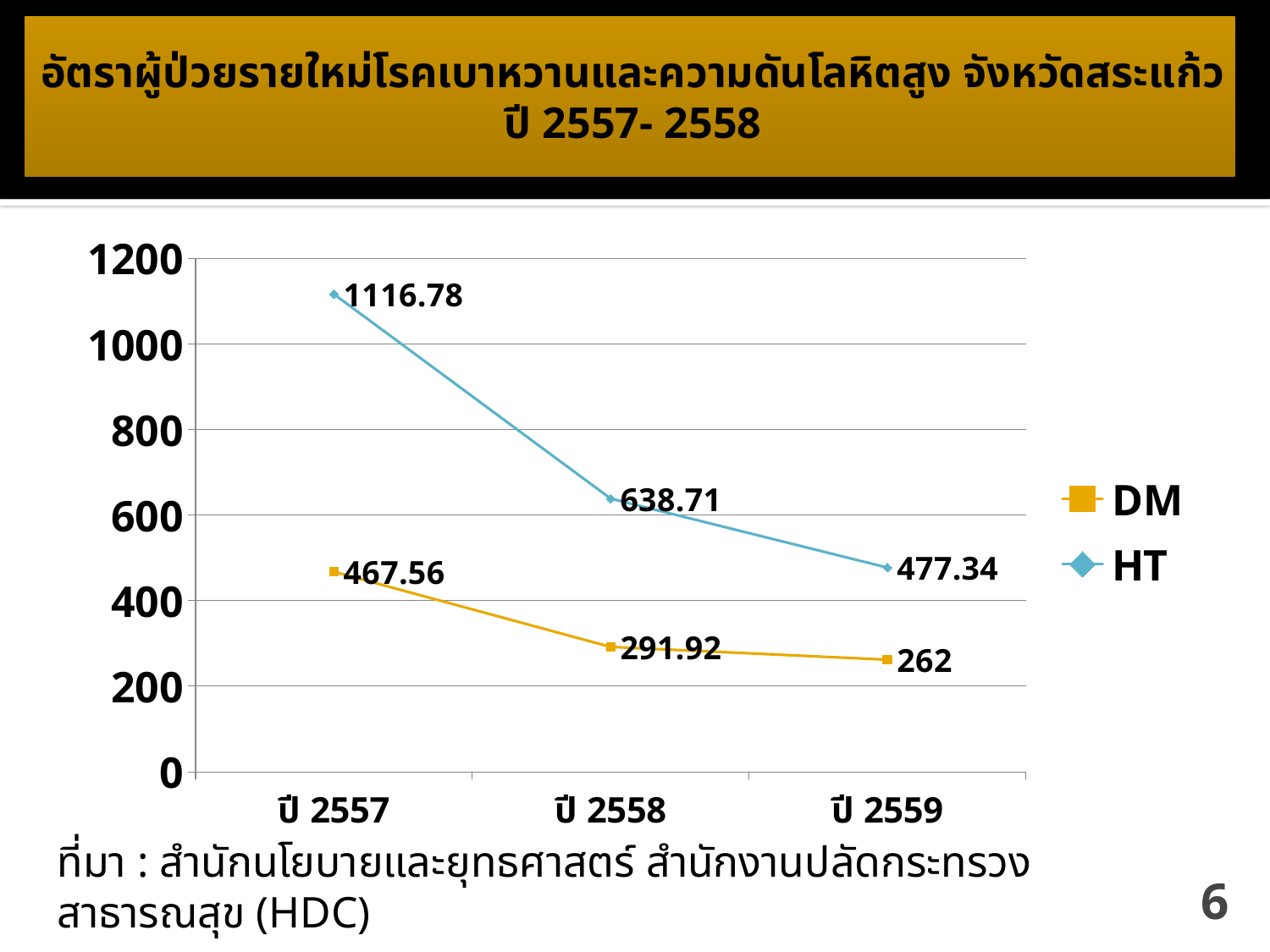
How many series does the legend list? 2 In which year is the HT value highest? ปี 2557 What is the DM value for ปี 2559? 262 Which is larger in ปี 2559, the HT value or the DM value? HT Do the HT values rise or fall from ปี 2557 to ปี 2559? fall In which year is the DM value lowest? ปี 2559 What is the difference between the HT and DM values in ปี 2558? 346.79 What is the HT value for ปี 2559? 477.34 What is the HT value for ปี 2557? 1116.78 What is the DM value for ปี 2558? 291.92 How many years are shown on the x axis? 3 What kind of chart is shown on the slide? line chart